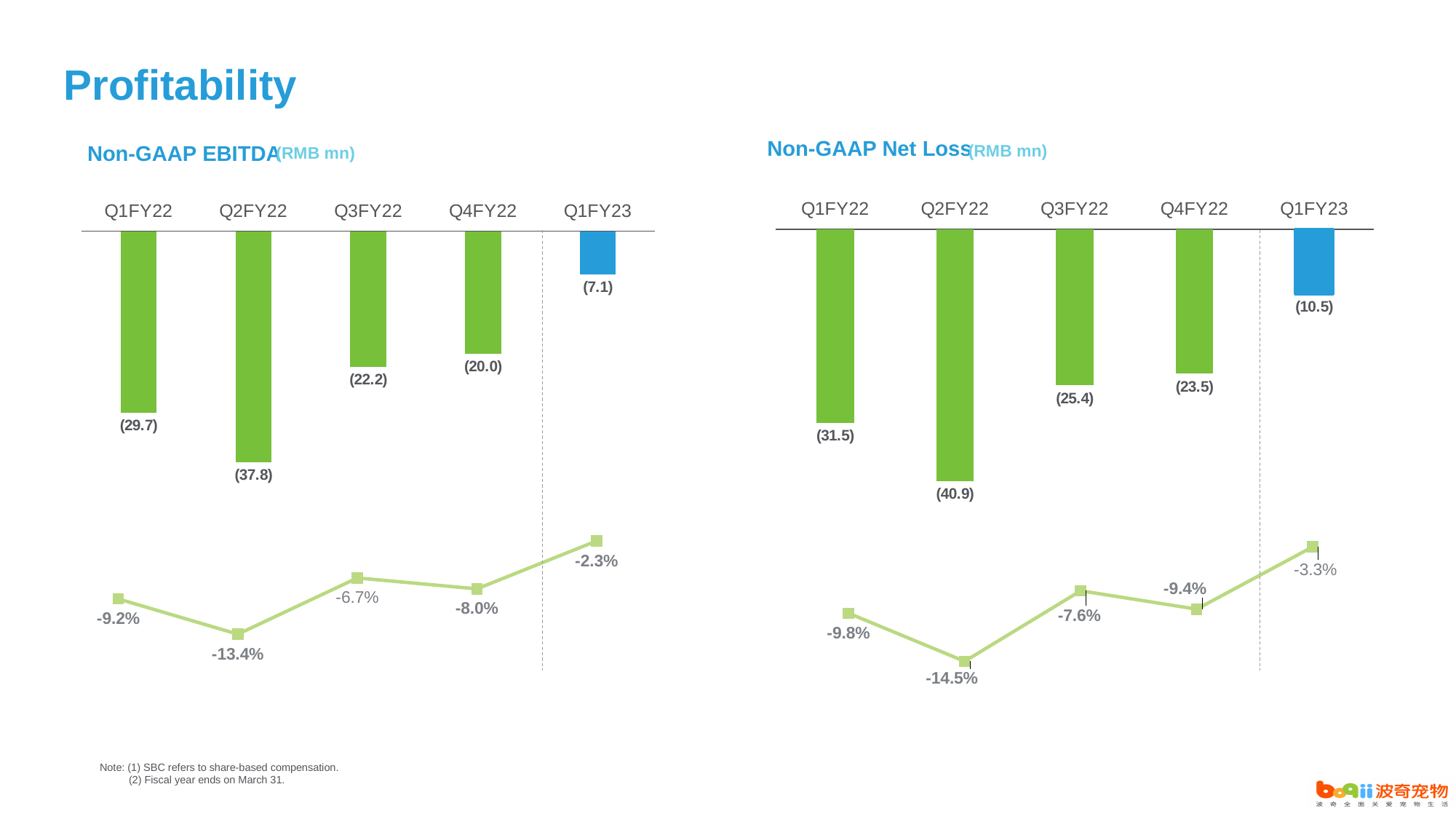
In the Non-GAAP EBITDA chart, which quarter has the largest loss bar? Q2FY22 In the Non-GAAP EBITDA chart, what is the value for Q2FY22? (37.8) In the Non-GAAP EBITDA chart, how many quarters are shown on the x axis? 5 In the Non-GAAP Net Loss chart, what is the value for Q1FY23? (10.5) In the Non-GAAP EBITDA chart, what percentage is shown on the line for Q2FY22? -13.4% In the Non-GAAP Net Loss chart, which bar is larger, Q3FY22 or Q4FY22? Q3FY22 In the Non-GAAP Net Loss chart, what percentage is shown on the line for Q1FY23? -3.3% In the Non-GAAP EBITDA chart, what is the value for Q1FY23? (7.1) In the Non-GAAP EBITDA chart, which quarter has the smallest loss bar? Q1FY23 What unit is shown next to the title of the Non-GAAP Net Loss chart? RMB mn In the Non-GAAP Net Loss chart, what is the value for Q2FY22? (40.9) In the Non-GAAP Net Loss chart, what is the difference between the Q2FY22 bar value (40.9) and the Q1FY23 bar value (10.5)? 30.4